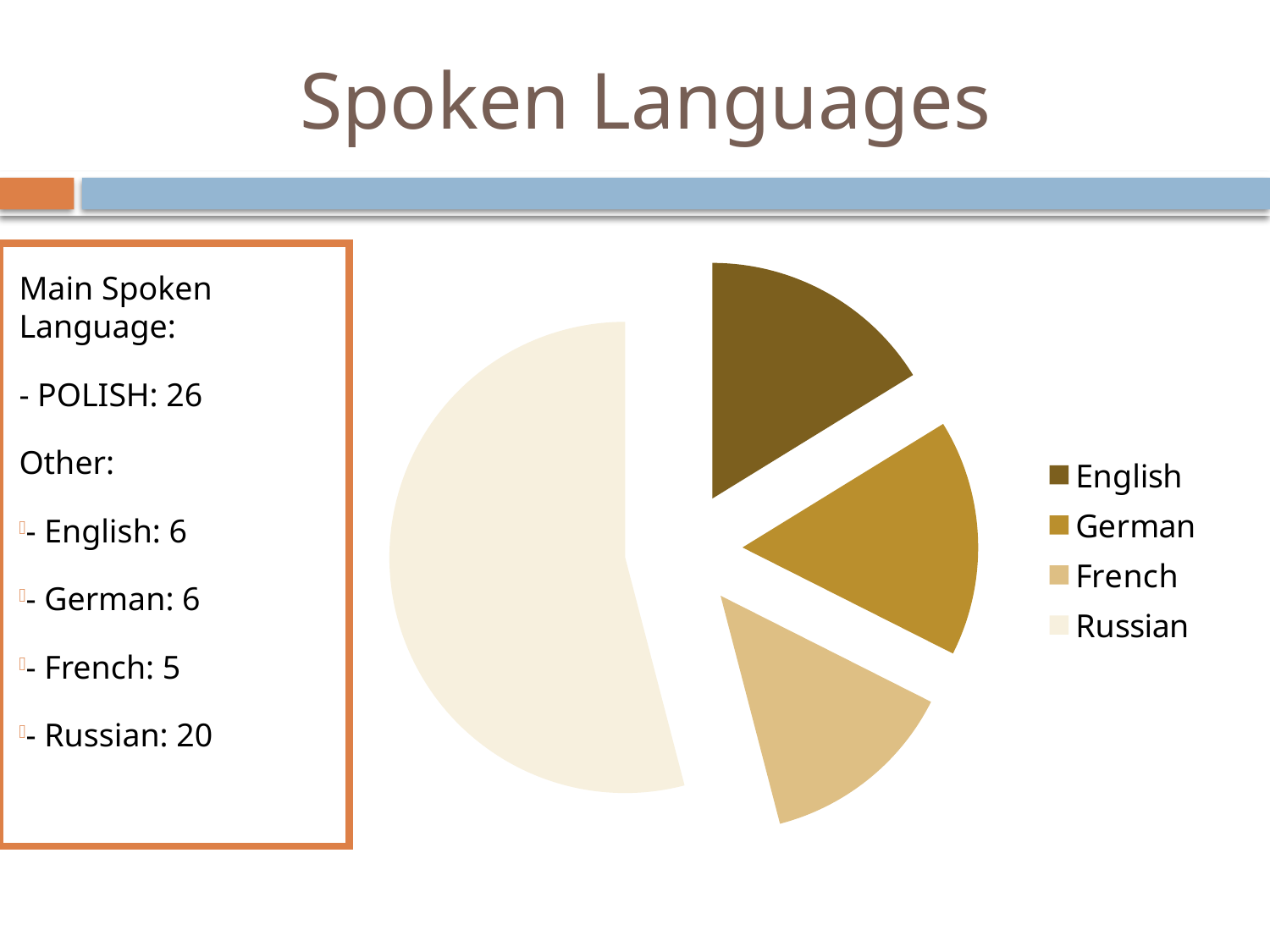
What is the title of the slide containing the pie chart? Spoken Languages According to the slide, how many speakers does the English slice of the pie chart represent? 6 Which legend entry of the pie chart is shown in the darkest brown colour? English Which slice is larger in the pie chart, Russian or English? Russian According to the slide, how many speakers does the Russian slice of the pie chart represent? 20 According to the slide, how many speakers does the French slice of the pie chart represent? 5 How many entries does the legend of the pie chart list? 4 Which slice is larger in the pie chart, Russian or French? Russian What kind of chart is shown on the slide? pie chart Which language has the largest slice in the pie chart? Russian What is the difference between the Russian and German values shown on the slide? 14 How many slices does the pie chart have? 4